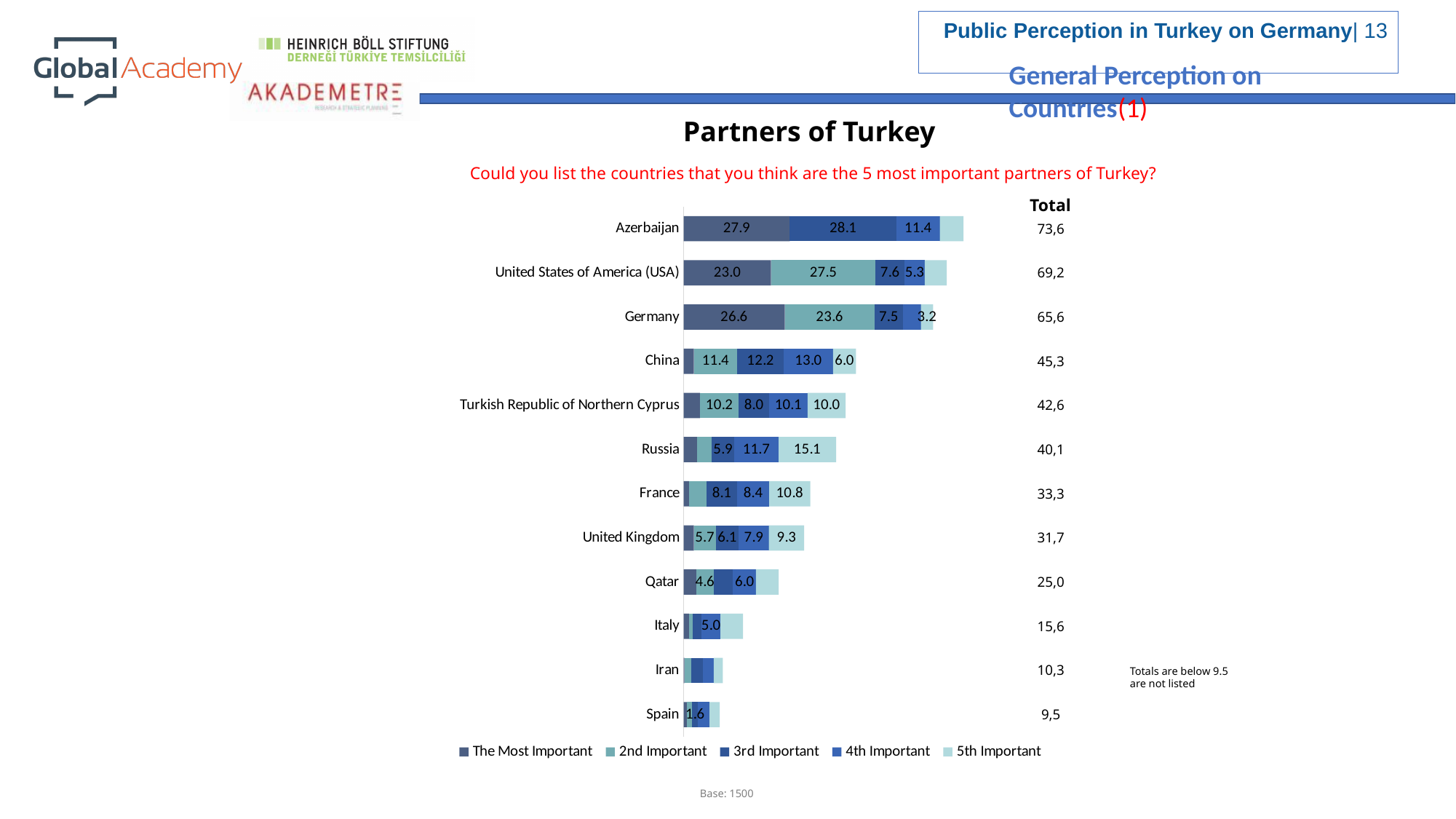
Which country has the lowest total? Spain What is the difference between the totals for Azerbaijan and United States of America (USA)? 4,4 Which has a larger total, Germany or China? Germany What is the 'The Most Important' value for United States of America (USA)? 23.0 What is the total for Azerbaijan? 73,6 How many series does the legend list? 5 What kind of chart is shown? Stacked bar chart What is the '5th Important' value for Russia? 15.1 What is the total for Germany? 65,6 Which country has the highest total? Azerbaijan How many countries are listed in the chart? 12 What is the 'The Most Important' value for Germany? 26.6